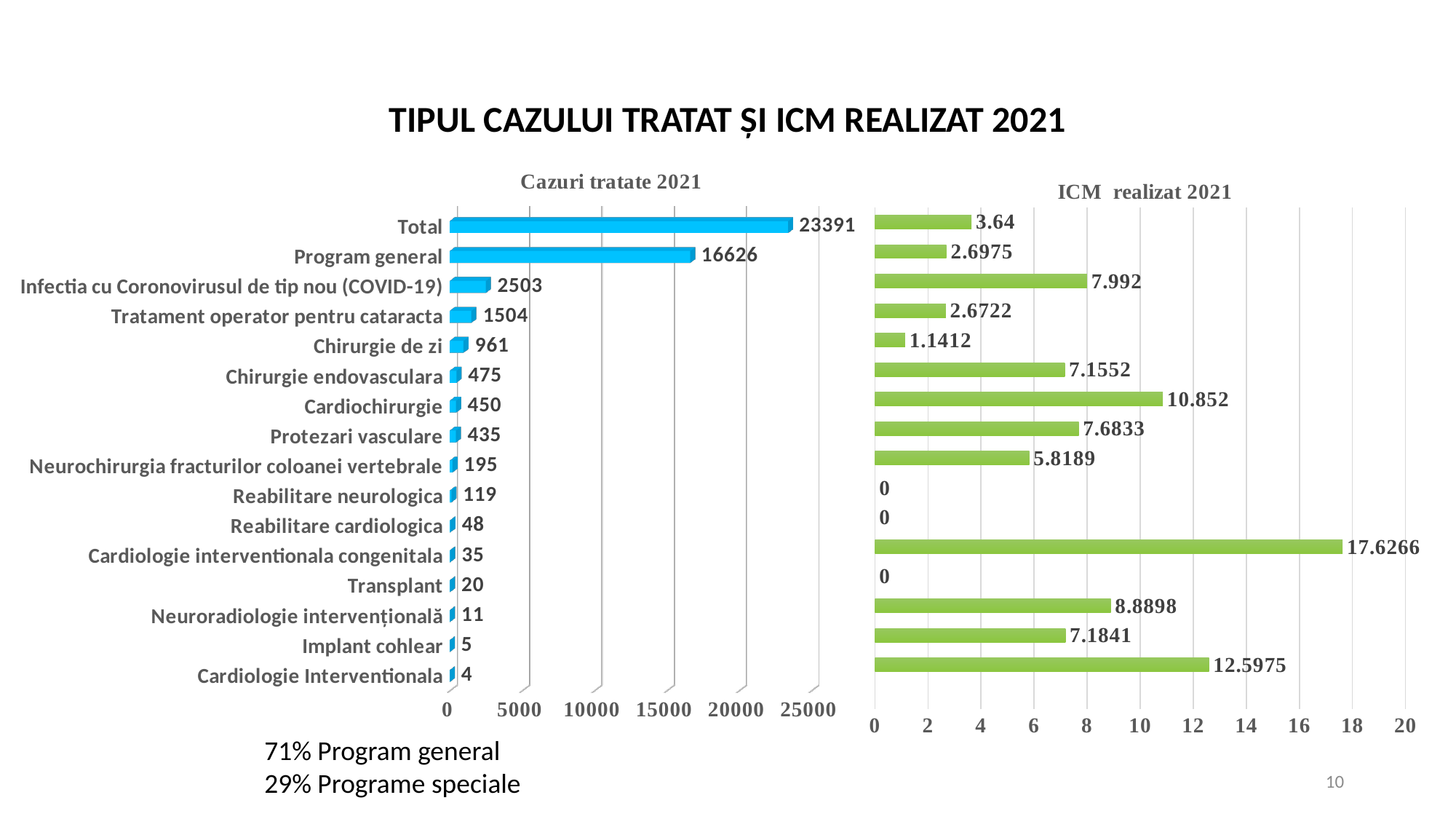
In the 'Cazuri tratate 2021' chart, is the value for Infectia cu Coronovirusul de tip nou (COVID-19) greater or less than 5000? less In the 'Cazuri tratate 2021' chart, what is the value for Tratament operator pentru cataracta? 1504 What is the title of the chart on the left side of the slide? Cazuri tratate 2021 How many categories are shown in the 'Cazuri tratate 2021' chart? 16 What kind of chart is 'ICM realizat 2021'? bar chart In the 'Cazuri tratate 2021' chart, which category has the lowest value? Cardiologie Interventionala In the 'ICM realizat 2021' chart, which category has the highest value? Cardiologie interventionala congenitala In the 'ICM realizat 2021' chart, what is the value for Total? 3.64 In the 'Cazuri tratate 2021' chart, what is the value for Program general? 16626 In the 'Cazuri tratate 2021' chart, what is the difference between Total and Program general? 6765 In the 'ICM realizat 2021' chart, which is larger: Neuroradiologie intervențională or Protezari vasculare? Neuroradiologie intervențională In the 'ICM realizat 2021' chart, what is the value for Cardiochirurgie? 10.852